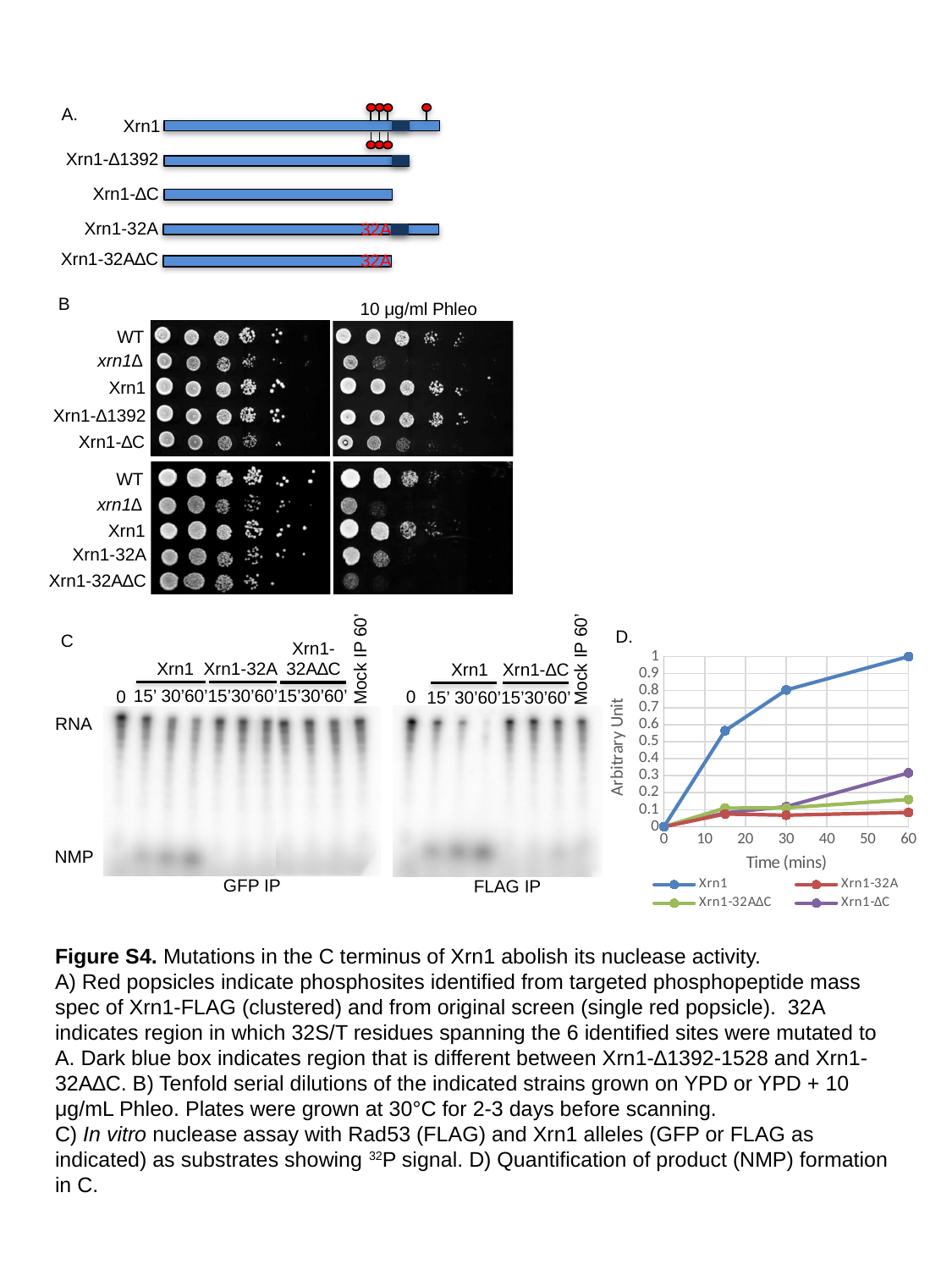
In chart D, what is the value of Xrn1 at 60 minutes? 1 In chart D, how many series does the legend list? 4 In chart D, is the value for Xrn1-ΔC at 60 minutes greater or less than 0.4? less In chart D, which is larger at 60 minutes, Xrn1-ΔC or Xrn1-32A? Xrn1-ΔC In chart D, is the value for Xrn1-32AΔC at 60 minutes greater or less than 0.2? less In chart D, is the value for Xrn1 at 15 minutes greater or less than 0.5? greater In chart D, which series has the lowest value at 60 minutes? Xrn1-32A In chart D, which series has the highest value at 60 minutes? Xrn1 In chart D, what is the label of the y axis? Arbitrary Unit In chart D, does the Xrn1 series rise or fall as time increases? rise In chart D, what is the label of the x axis? Time (mins) In chart D, what kind of chart is shown? line chart